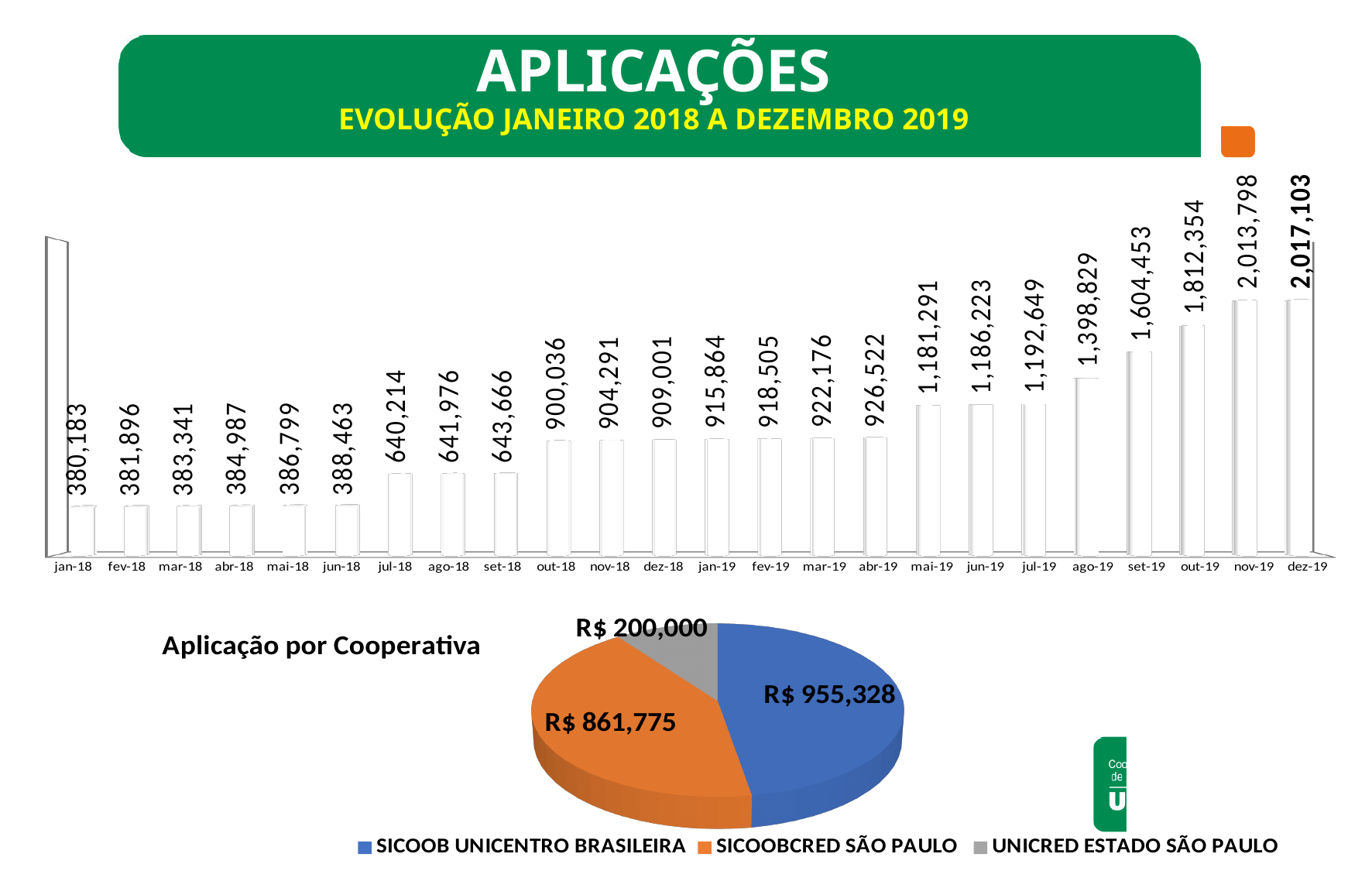
In the top bar chart, what is the value for jan-18? 380,183 In the top bar chart, what is the value for dez-19? 2,017,103 What kind of chart is the top chart on the slide? bar chart In the top bar chart, what is the difference between the values for dez-19 and jan-18? 1,636,920 In the pie chart 'Aplicação por Cooperativa', which cooperative has the largest slice? SICOOB UNICENTRO BRASILEIRA In the pie chart 'Aplicação por Cooperativa', what is the value for SICOOBCRED SÃO PAULO? R$ 861,775 In the top bar chart, what is the value for jul-18? 640,214 In the top bar chart, do the values rise or fall from jan-18 to dez-19? rise In the top bar chart, which month has the highest value? dez-19 In the top bar chart, which month has the lowest value? jan-18 In the pie chart 'Aplicação por Cooperativa', how many cooperatives does the legend list? 3 In the top bar chart, how many months are plotted? 24